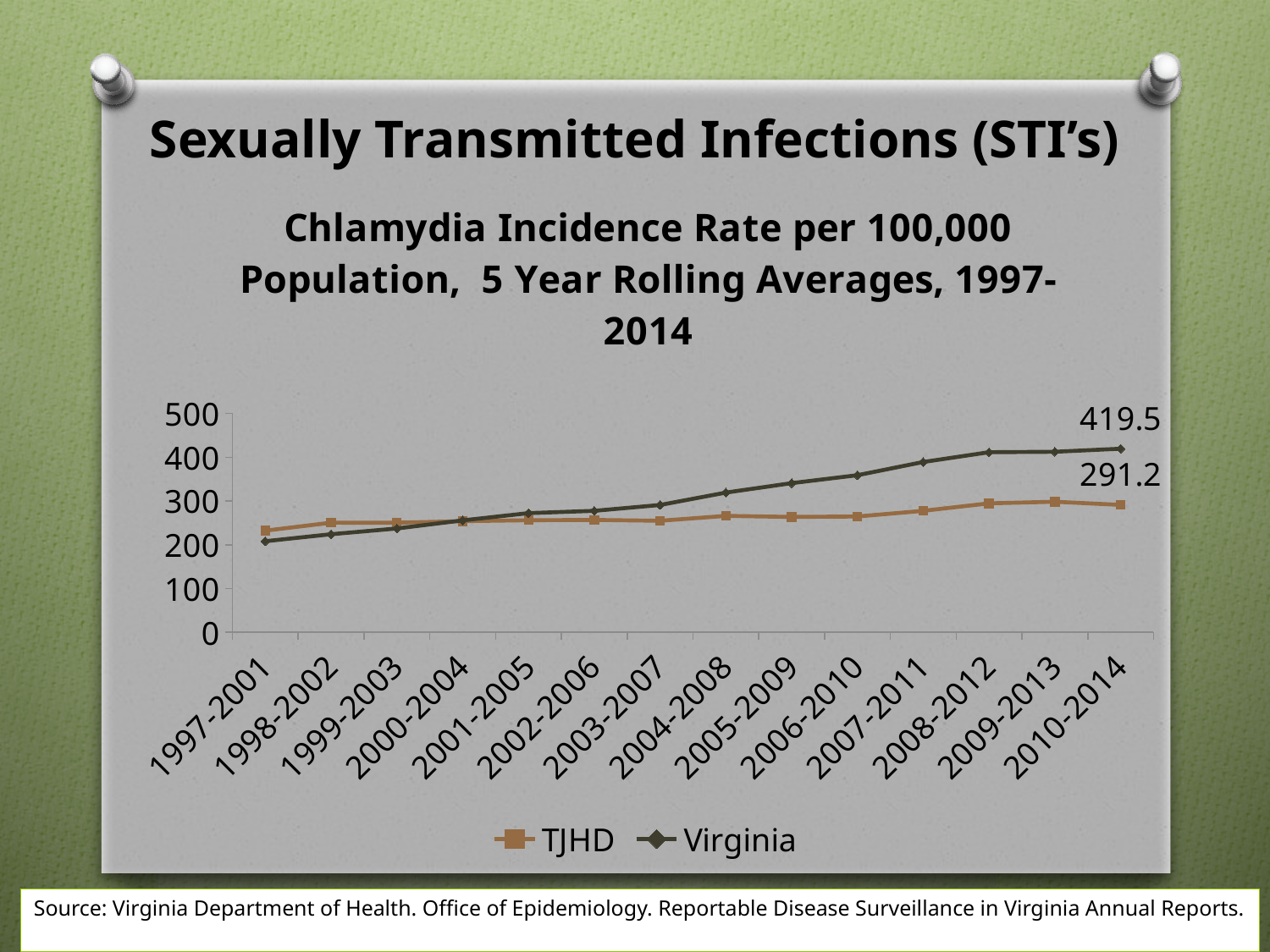
What kind of chart is shown on the slide? line chart How many 5-year periods are shown on the x axis? 14 What is the difference between the Virginia and TJHD rates for 2010-2014? 128.3 What is the Virginia chlamydia incidence rate for 2010-2014? 419.5 In which period is the Virginia series at its lowest? 1997-2001 Does the Virginia series generally rise or fall from 1997-2001 to 2010-2014? rise What is the TJHD chlamydia incidence rate for 2010-2014? 291.2 Is the Virginia value for 1997-2001 greater or less than 300? less Which series has the higher value for 2010-2014, TJHD or Virginia? Virginia Is the TJHD value for 2008-2012 greater or less than 200? greater How many series does the legend list? 2 Is the Virginia value for 2006-2010 greater or less than 300? greater